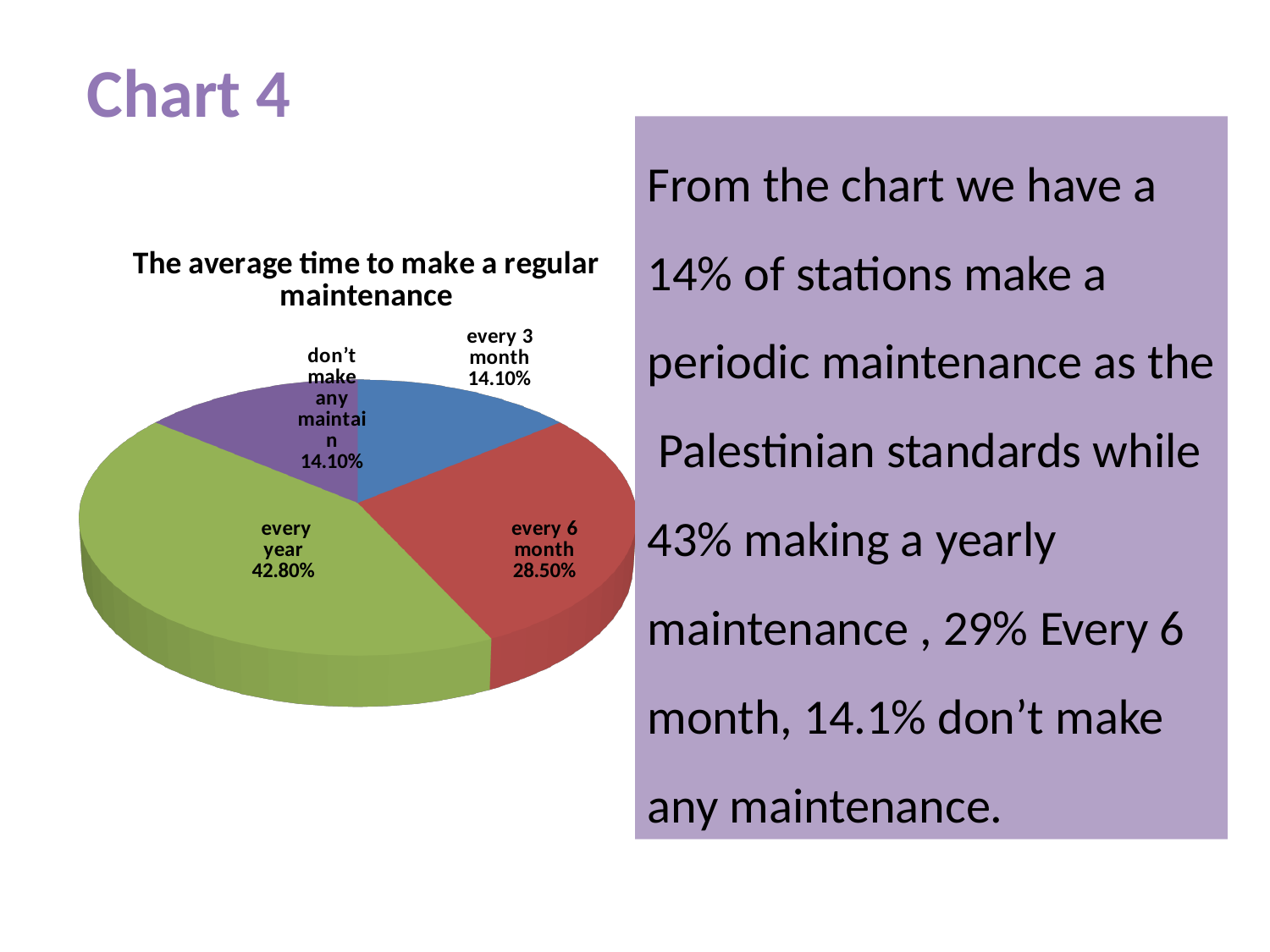
Which is larger, the share for "every 6 month" or the share for "every 3 month"? every 6 month What is the difference between the "every 6 month" share and the "every 3 month" share? 14.40% Which category has the largest share of the pie? every year What percentage of the pie is labelled "every 6 month"? 28.50% Which is larger, the share for "every year" or the share for "don't make any maintain"? every year What percentage of the pie is labelled "every year"? 42.80% What percentage of the pie is labelled "every 3 month"? 14.10% What percentage of the pie is labelled "don't make any maintain"? 14.10% What is the difference between the "every year" share and the "every 6 month" share? 14.30% What is the title of the chart? The average time to make a regular maintenance How many categories are shown in the pie chart? 4 What kind of chart is shown on the slide? pie chart